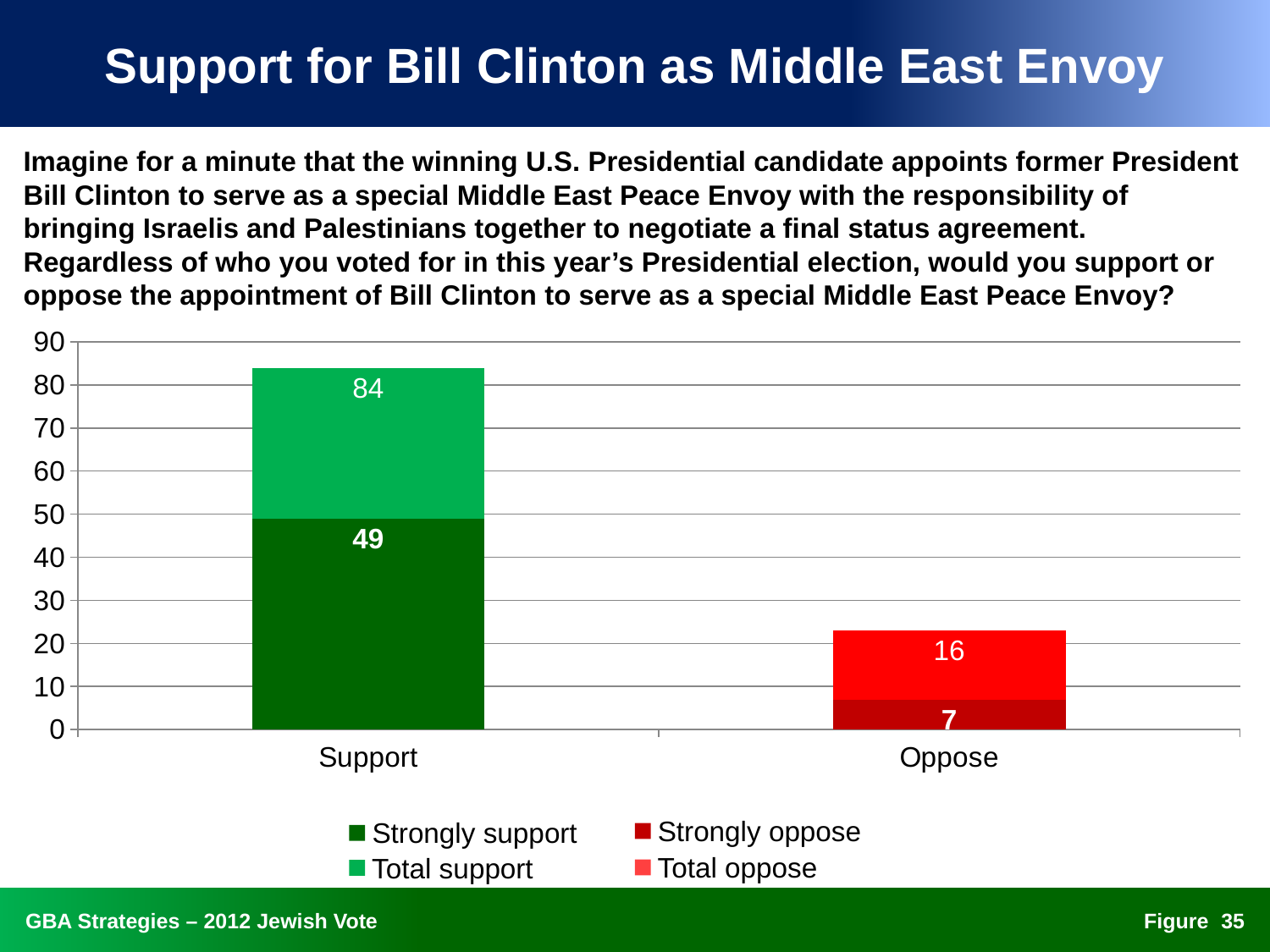
What is the value labelled for Strongly support in the Support bar? 49 How many series does the legend list? 4 Which is larger, Strongly support or Total oppose? Strongly support Which category has the shorter bar? Oppose What is the value labelled for Total oppose? 16 What is the difference between Strongly support and Strongly oppose? 42 What is the value labelled for Strongly oppose in the Oppose bar? 7 What is the difference between Total support and Total oppose? 68 What kind of chart is shown on the slide? Bar chart What is the value labelled for Total support? 84 Which category has the taller bar, Support or Oppose? Support How many categories are shown on the x axis? 2